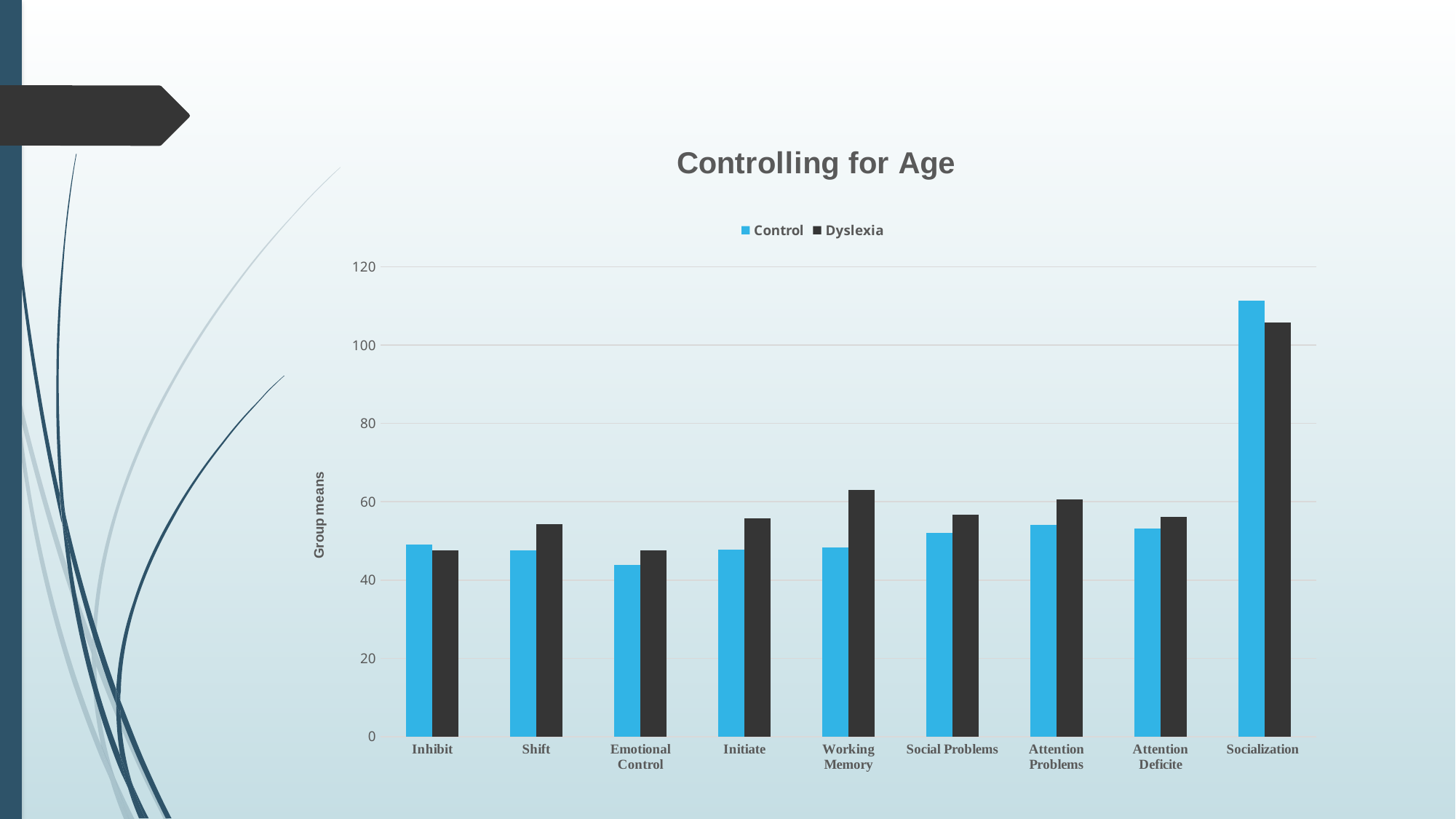
Which category has the lowest value for the Control series? Emotional Control Which category has the highest value for the Control series? Socialization How many categories are shown on the x axis? 9 Is the Control value for Socialization greater or less than 100? greater What is the title of the chart? Controlling for Age Which category has the highest value for the Dyslexia series? Socialization How many series does the legend list? 2 What kind of chart is shown on the slide? bar chart For Working Memory, which series has the larger value, Control or Dyslexia? Dyslexia Is the Dyslexia value for Working Memory greater or less than 60? greater Is the Control value for Emotional Control greater or less than 40? greater For Socialization, which series has the larger value, Control or Dyslexia? Control